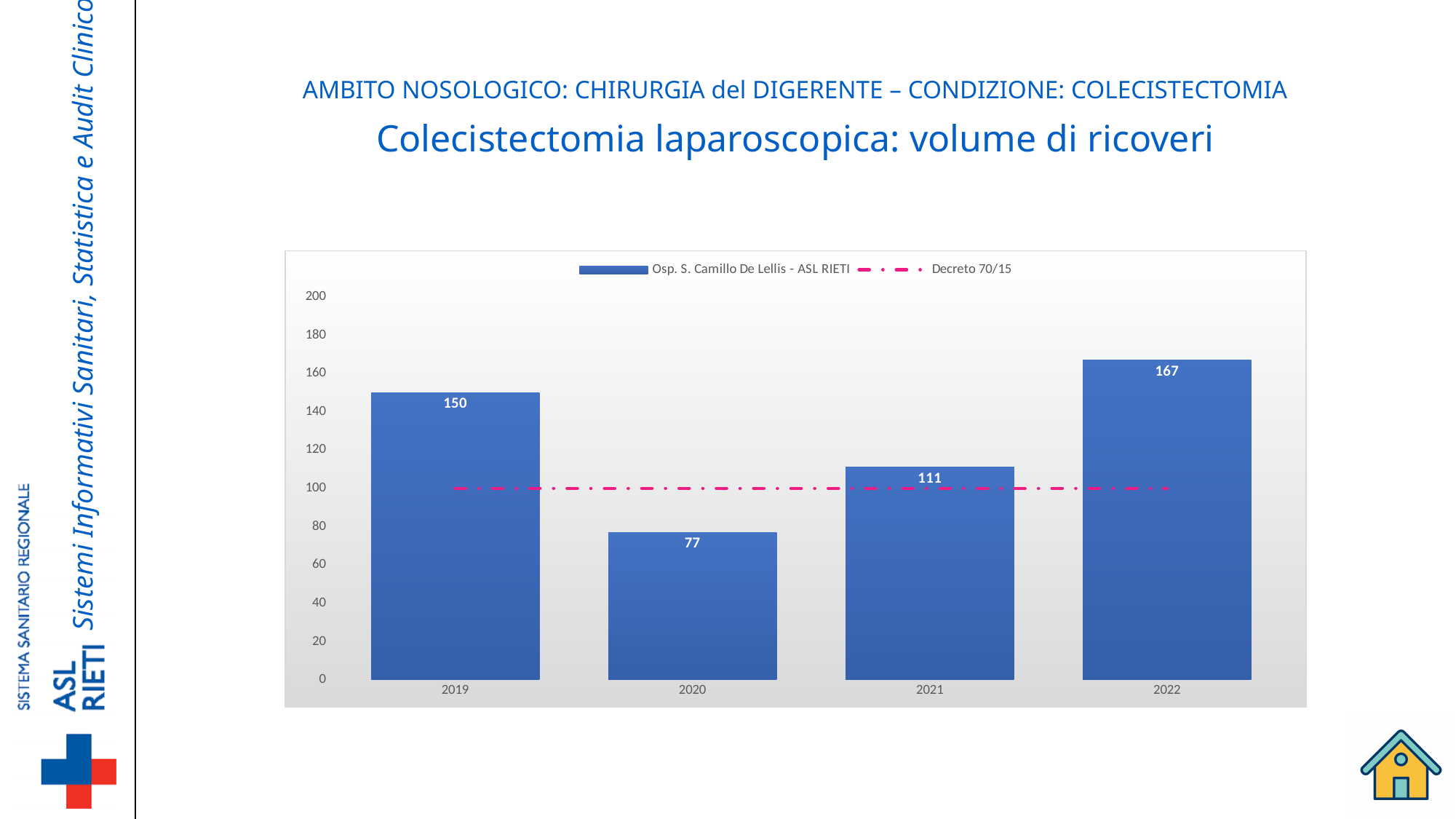
What is the value for 2020? 77 How many entries does the legend list? 2 Which is larger, the value for 2021 or the value for 2019? 2019 What is the value for 2022? 167 What is the value for 2021? 111 Which year has the highest value? 2022 What is the value for 2019? 150 How many years are shown on the x axis? 4 What is the difference between the values for 2022 and 2019? 17 What kind of chart is shown? bar chart Is the value for 2020 greater or less than 100? less Which year has the lowest value? 2020